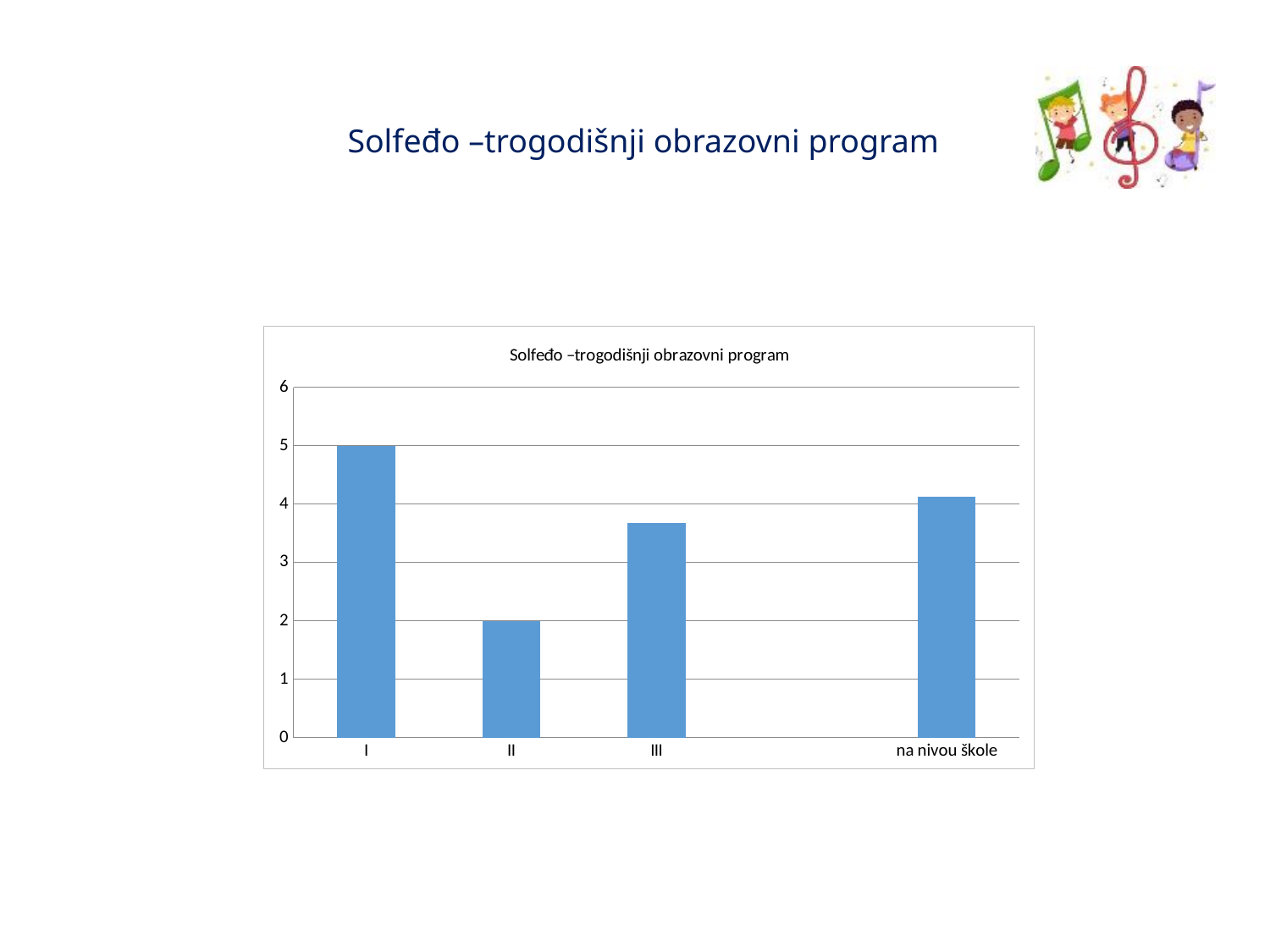
What is the value for category II? 2 What is the difference between the values for I and II? 3 Is the value for III greater or less than 4? less What kind of chart is shown on the slide? bar chart Is the value for na nivou škole greater or less than 4? greater How many categories are shown on the x axis? 4 Which category has the lowest value? II Which is larger, the value for I or the value for III? I What is the title of the chart? Solfeđo –trogodišnji obrazovni program Which is larger, the value for II or the value for na nivou škole? na nivou škole What is the value for category I? 5 Which category has the highest value? I